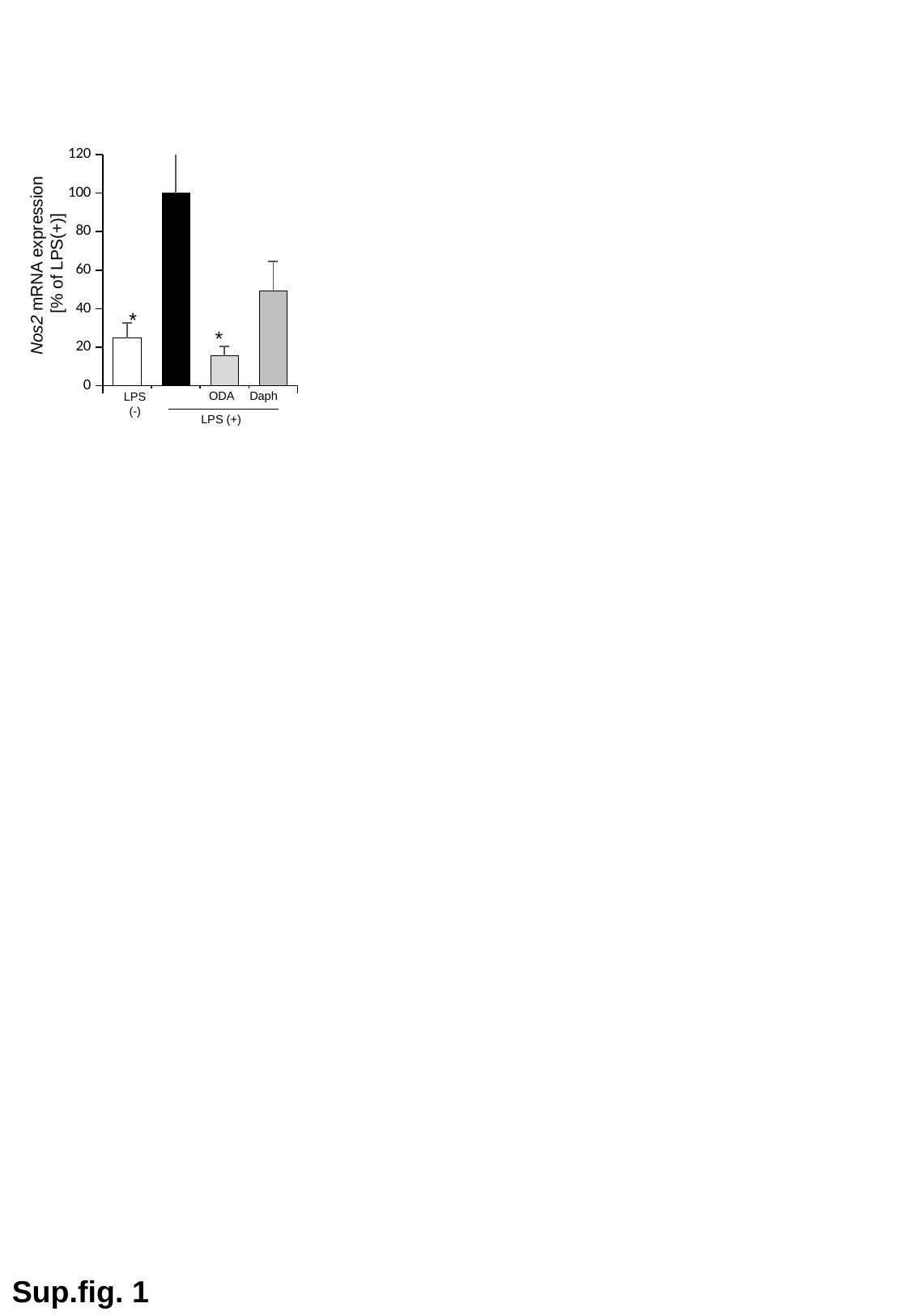
Which is larger, the value for Daph or the value for ODA? Daph Is the value for ODA greater or less than 20? less What is the label of the y axis? Nos2 mRNA expression [% of LPS(+)] Is the value for Daph greater or less than 60? less Which bar has the highest Nos2 mRNA expression? the black LPS (+) bar What is the Nos2 mRNA expression value of the black LPS (+) bar? 100 Is the value for Daph greater or less than 40? greater What kind of chart is shown on the slide? bar chart Which labelled category has the lowest Nos2 mRNA expression? ODA Which bars are marked with an asterisk? LPS (-) and ODA How many bars are plotted in the chart? 4